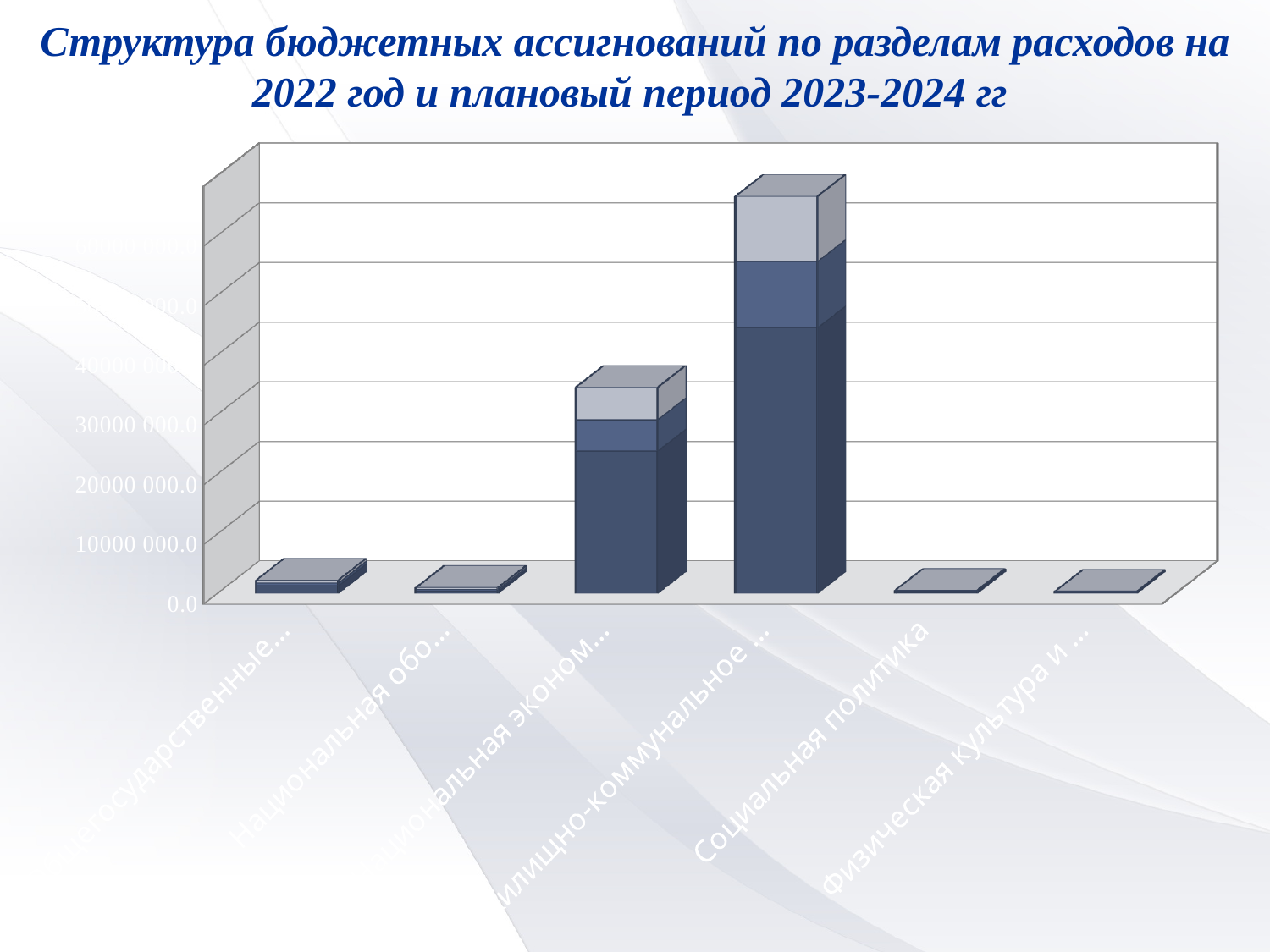
Is the value for Общегосударственные... greater or less than 10000 000.0? less How many categories are shown along the x axis of the chart? 6 Is the value for Социальная политика greater or less than 10000 000.0? less How many stacked segments make up each bar in the chart? 3 Which category has the tallest bar in the chart? Жилищно-коммунальное ... Which is larger, the bar for Жилищно-коммунальное ... or the bar for Национальная эконом...? Жилищно-коммунальное ... What is the title of the slide containing the chart? Структура бюджетных ассигнований по разделам расходов на 2022 год и плановый период 2023-2024 гг Which is larger, the bar for Национальная эконом... or the bar for Социальная политика? Национальная эконом... What kind of chart is shown on the slide? Bar chart (stacked, 3D) Is the total value for Национальная эконом... greater or less than 20000 000.0? greater